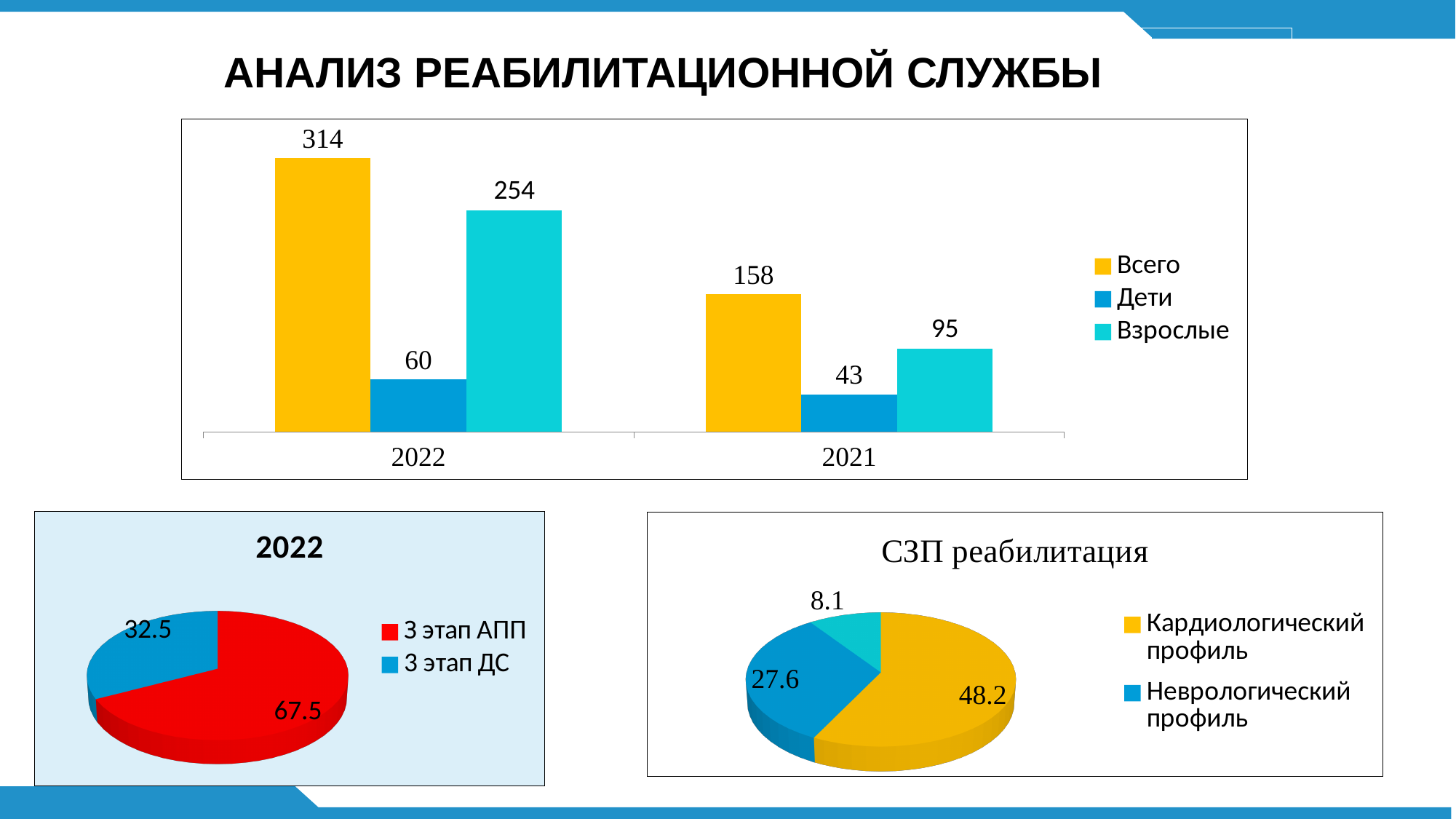
In the top bar chart, which series has the lowest value in 2022? Дети How many series does the legend of the top bar chart list? 3 In the top bar chart, what is the value for Дети in 2021? 43 In the top bar chart, what is the value for Взрослые in 2022? 254 In the top bar chart, what is the value for Всего in 2022? 314 In the pie chart titled СЗП реабилитация, what is the difference between Кардиологический профиль and Неврологический профиль? 20.6 In the top bar chart, is the value for Взрослые larger in 2022 or in 2021? 2022 In the bottom-left pie chart titled 2022, what is the value for 3 этап АПП? 67.5 In the pie chart titled СЗП реабилитация, what is the value for Неврологический профиль? 27.6 In the bottom-left pie chart titled 2022, which slice is larger: 3 этап АПП or 3 этап ДС? 3 этап АПП What kind of chart is the top chart on the slide? Bar chart In the top bar chart, what is the difference between Всего in 2022 and Всего in 2021? 156